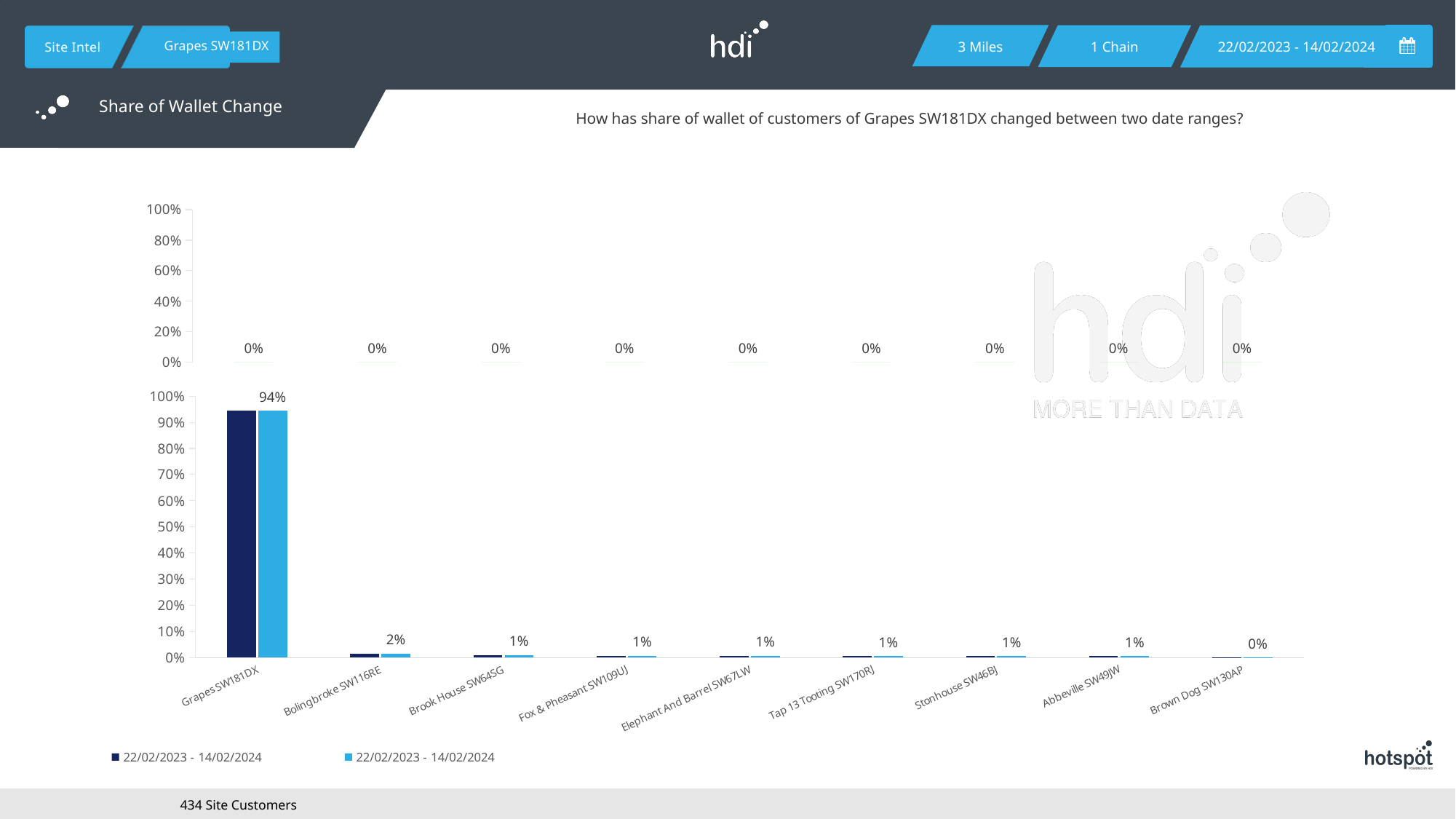
On the bottom chart, which category has the lowest labelled share of wallet? Brown Dog SW130AP On the bottom chart, is the value for Grapes SW181DX greater or less than 50%? greater On the bottom chart, what is the labelled share of wallet value for Grapes SW181DX? 94% On the bottom chart, which is larger: the value for Grapes SW181DX or the value for Bolingbroke SW116RE? Grapes SW181DX How many series does the legend of the bottom chart list? 2 On the bottom chart, what is the labelled value for Brown Dog SW130AP? 0% On the bottom chart, which category has the highest share of wallet? Grapes SW181DX How many categories are shown on the x axis of the bottom chart? 9 On the bottom chart, what is the labelled value for Bolingbroke SW116RE? 2% What kind of chart is the bottom chart? bar chart On the top chart, what value is labelled for every category? 0% On the bottom chart, what is the difference between the labelled values for Grapes SW181DX and Bolingbroke SW116RE? 92 percentage points